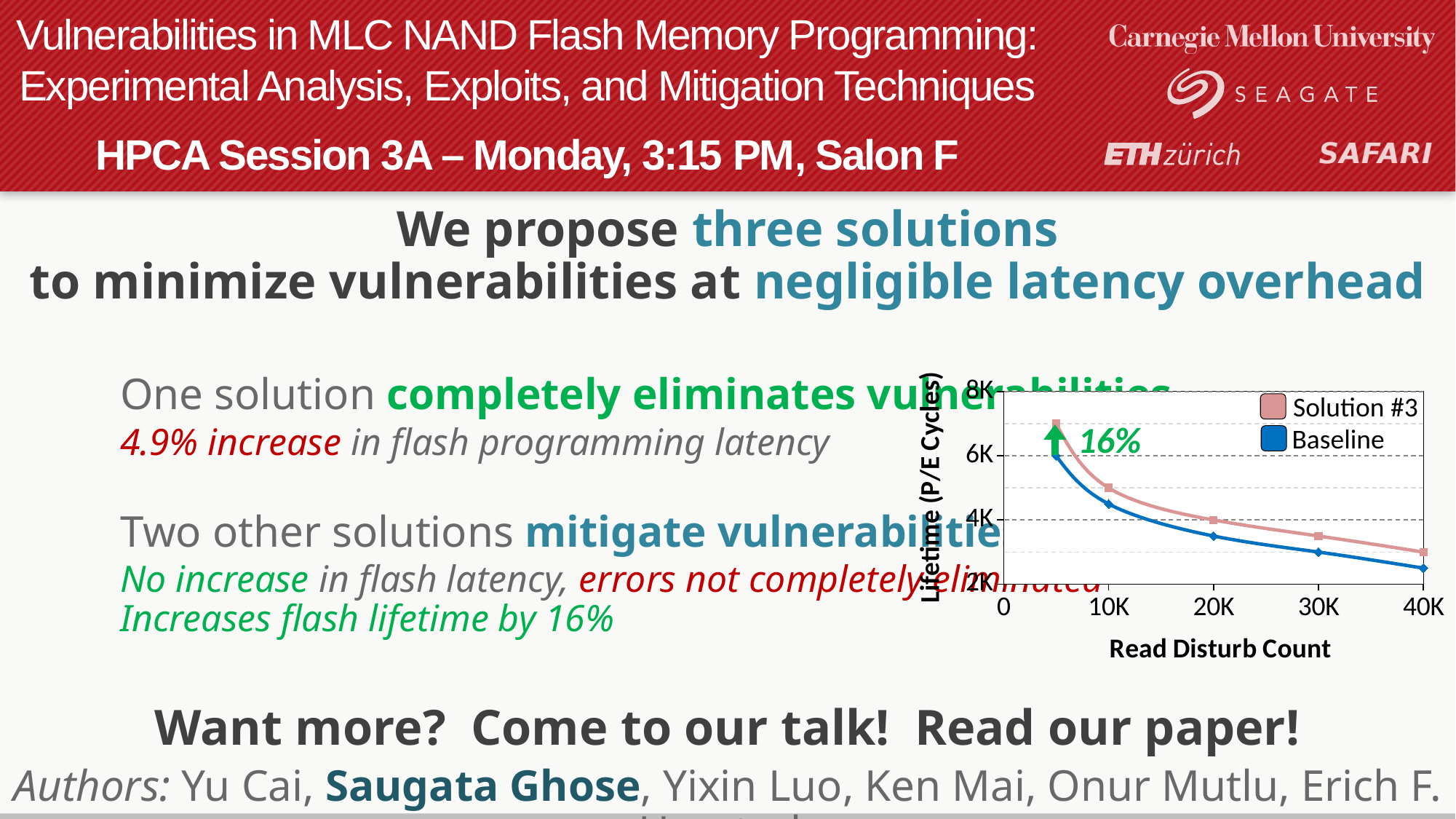
What are the two series named in the chart's legend? Solution #3 and Baseline What is the label of the chart's x axis? Read Disturb Count Is the Baseline lifetime at a read disturb count of 30K greater or less than 4K? less What kind of chart is shown on the slide? line chart At which read disturb count is the Baseline lifetime lowest? 40K Is the Baseline lifetime at a read disturb count of 10K greater or less than 4K? greater Is the Solution #3 lifetime at a read disturb count of 10K greater or less than 6K? less Do the lifetime values rise or fall as the read disturb count increases? fall At a read disturb count of 40K, which series has the higher lifetime, Solution #3 or Baseline? Solution #3 What percentage improvement is annotated on the chart next to the green arrow? 16% How many series does the chart's legend list? 2